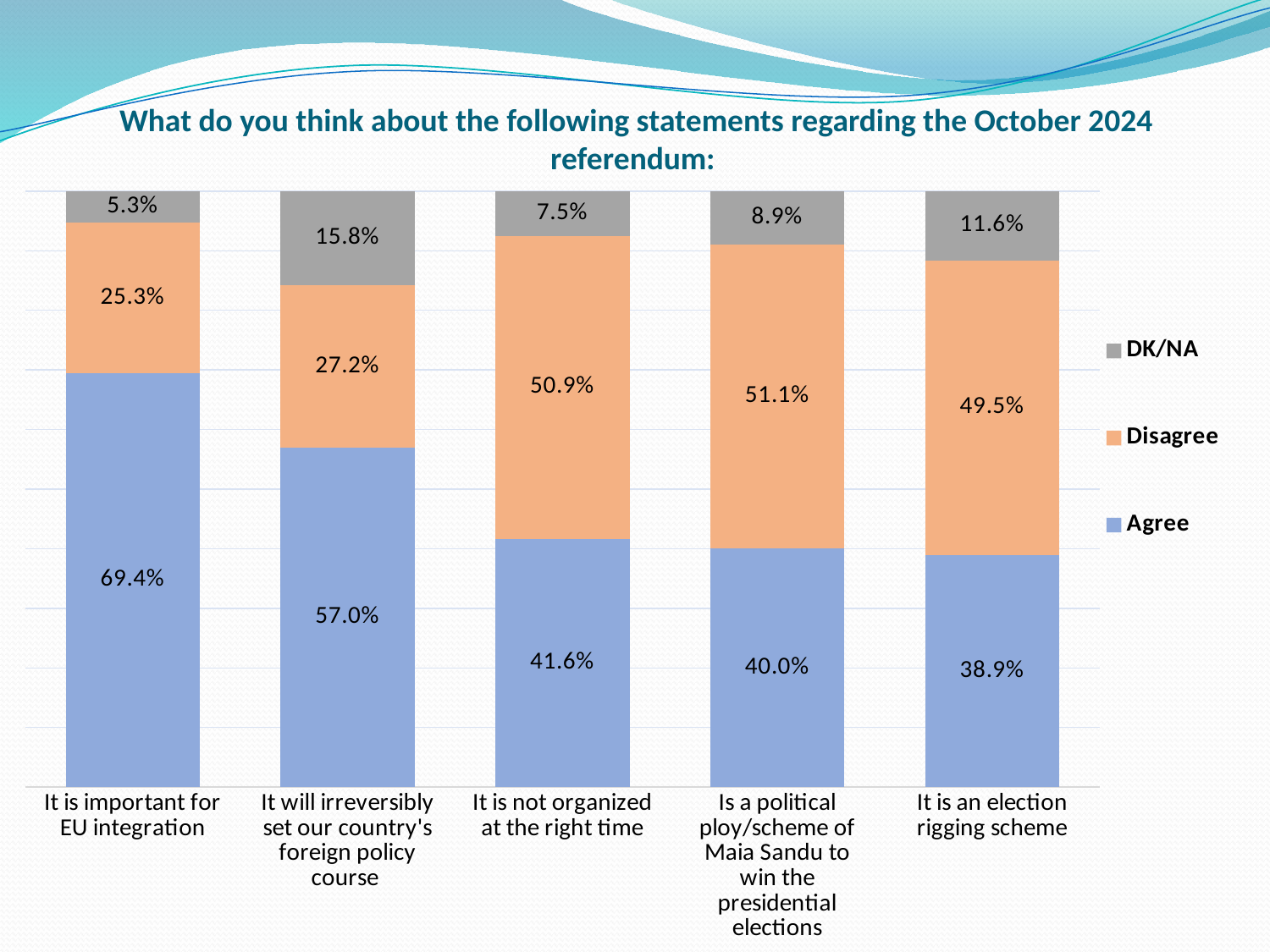
What is the total of the stacked bar for 'It is an election rigging scheme'? 100.0% What is the DK/NA value for the statement 'It will irreversibly set our country's foreign policy course'? 15.8% Which statement has the lowest DK/NA value? It is important for EU integration What kind of chart is shown on the slide? Stacked bar chart Which statement has the highest Agree value? It is important for EU integration What is the difference between the Agree values for 'It is important for EU integration' and 'It will irreversibly set our country's foreign policy course'? 12.4 percentage points What is the Disagree value for the statement 'Is a political ploy/scheme of Maia Sandu to win the presidential elections'? 51.1% Which is larger: the Disagree value for 'It is not organized at the right time' or the Disagree value for 'It is an election rigging scheme'? It is not organized at the right time What percentage of respondents agree that the referendum is important for EU integration? 69.4% How many series does the legend list? 3 How many statements (categories) are shown on the x axis? 5 Which colour represents the Disagree series in the legend? Orange